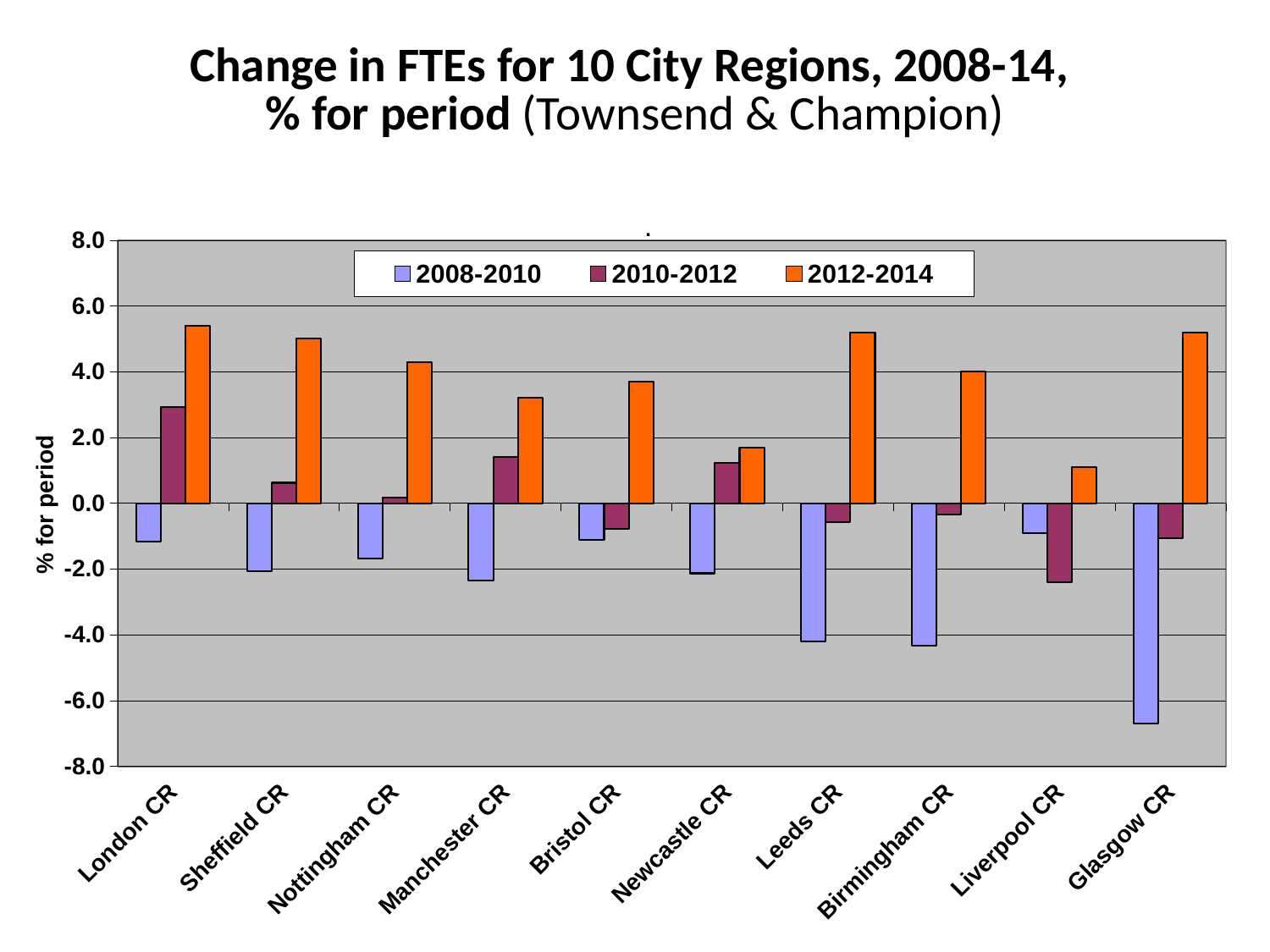
Which city region has the lowest value for 2010-2012? Liverpool CR Which city region has the highest value for 2010-2012? London CR What kind of chart is shown on the slide? bar chart Which is larger, the 2010-2012 value for London CR or the 2010-2012 value for Sheffield CR? London CR Which city region has the lowest value for 2008-2010? Glasgow CR How many city regions are shown on the x axis? 10 Is the 2008-2010 value for Glasgow CR greater or less than -6.0? less What is the label on the y axis? % for period Which city region has the lowest value for 2012-2014? Liverpool CR How many series does the legend list? 3 Is the 2012-2014 value for London CR greater or less than 4.0? greater Is the 2012-2014 value for Liverpool CR greater or less than 2.0? less